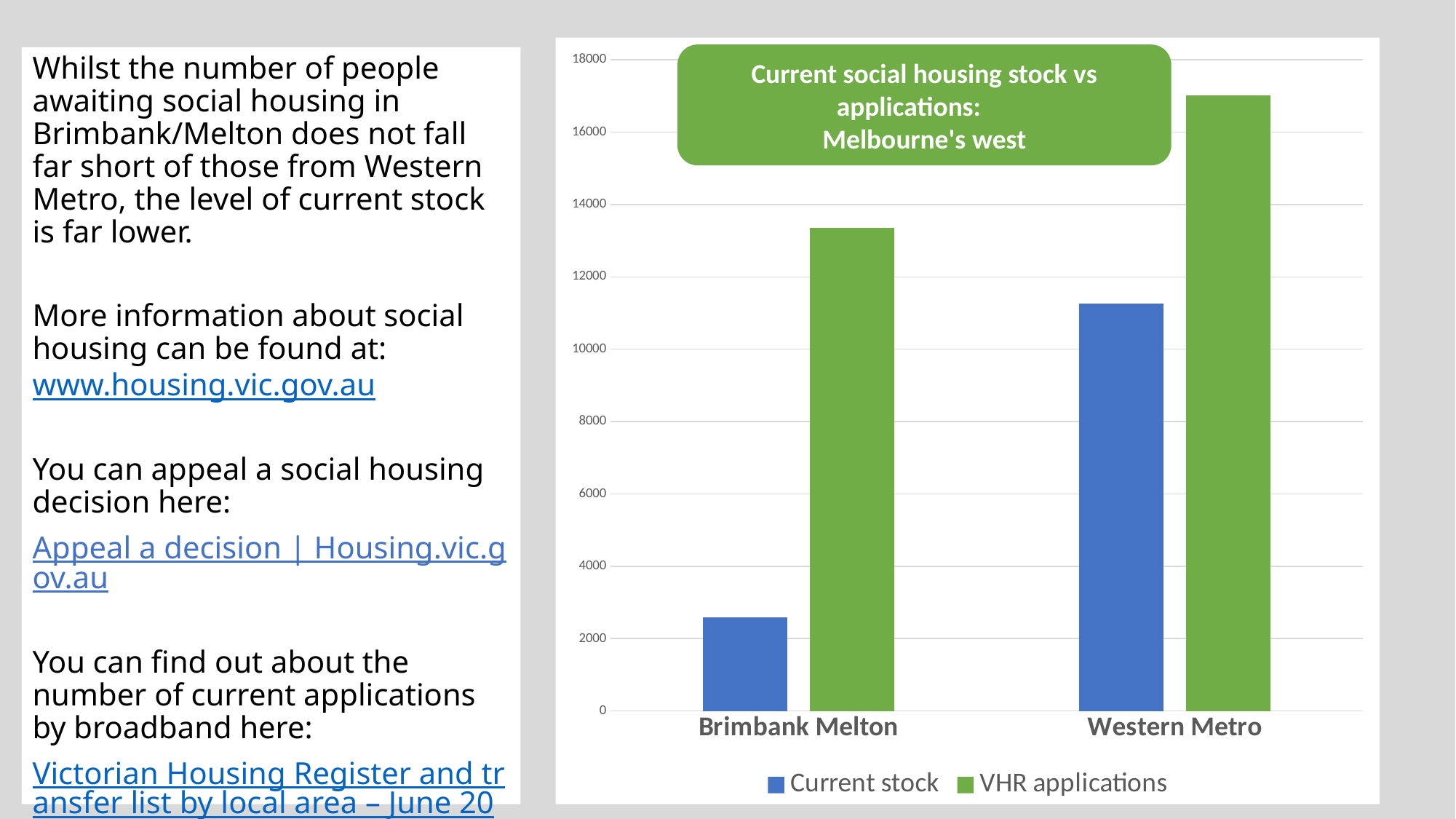
Is the VHR applications value for Brimbank Melton greater or less than 12000? greater How many series does the chart legend list? 2 How many categories are shown on the x axis of the chart? 2 Is the Current stock value for Western Metro greater or less than 10000? greater Which category has the higher Current stock value? Western Metro What is the title of the chart? Current social housing stock vs applications: Melbourne's west What kind of chart is shown on the slide? bar chart Which category has the lower VHR applications value? Brimbank Melton Is the VHR applications value for Western Metro greater or less than 16000? greater Which series is shown in green in the chart? VHR applications For Brimbank Melton, which is larger: Current stock or VHR applications? VHR applications